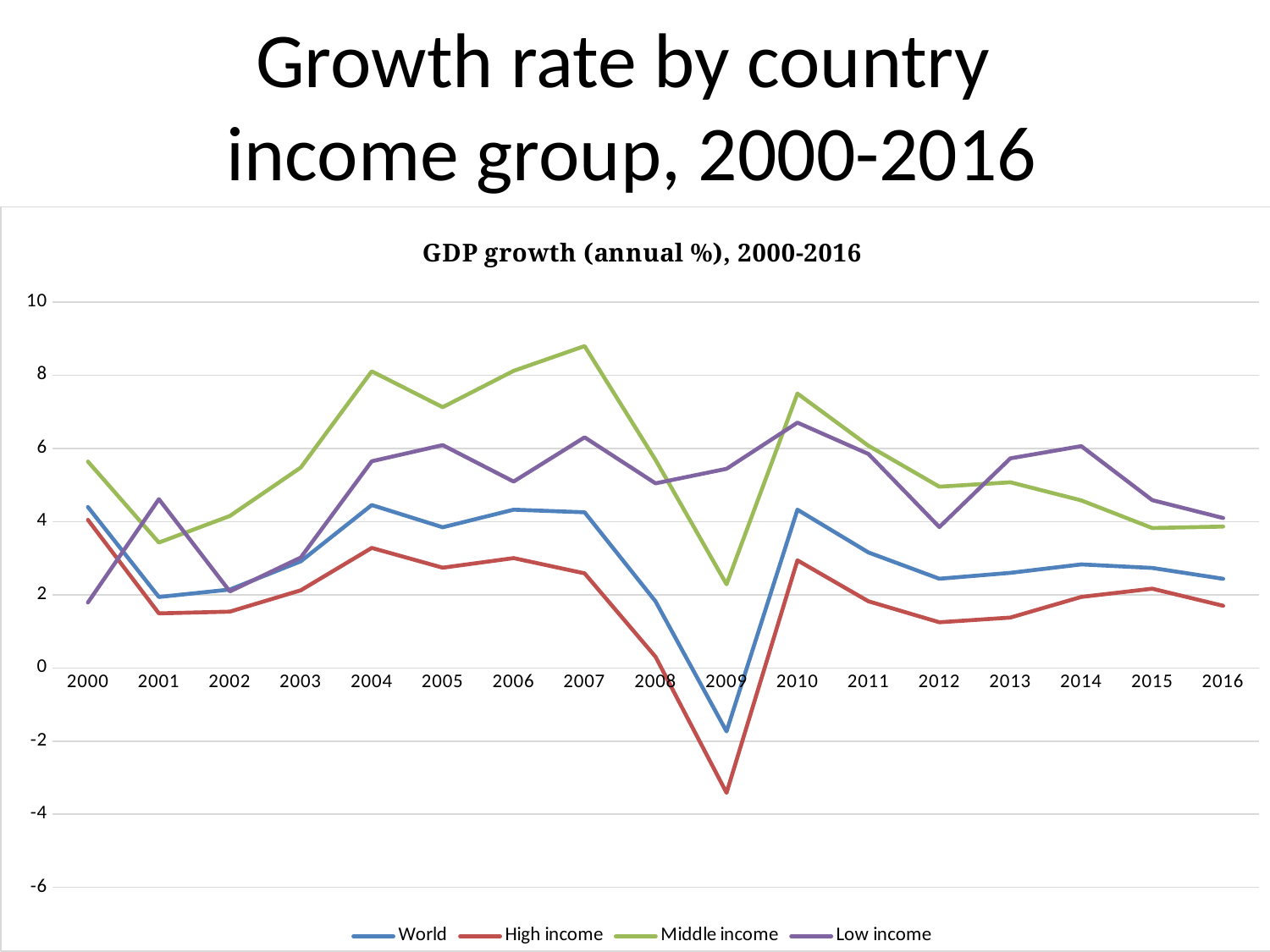
What kind of chart is shown on the slide? line chart How many series does the legend list? 4 In 2000, which series has the higher value, Low income or High income? High income In which year does the Middle income series reach its highest value? 2007 What is the title printed inside the chart area? GDP growth (annual %), 2000-2016 Is the Middle income value for 2007 greater or less than 8? greater In which year does the World series reach its lowest value? 2009 Does the World series rise or fall between 2007 and 2009? fall Is the High income value for 2009 greater or less than -2? less In which year does the High income series reach its lowest value? 2009 Is the Low income value for 2010 greater or less than 6? greater How many years are plotted along the x axis? 17